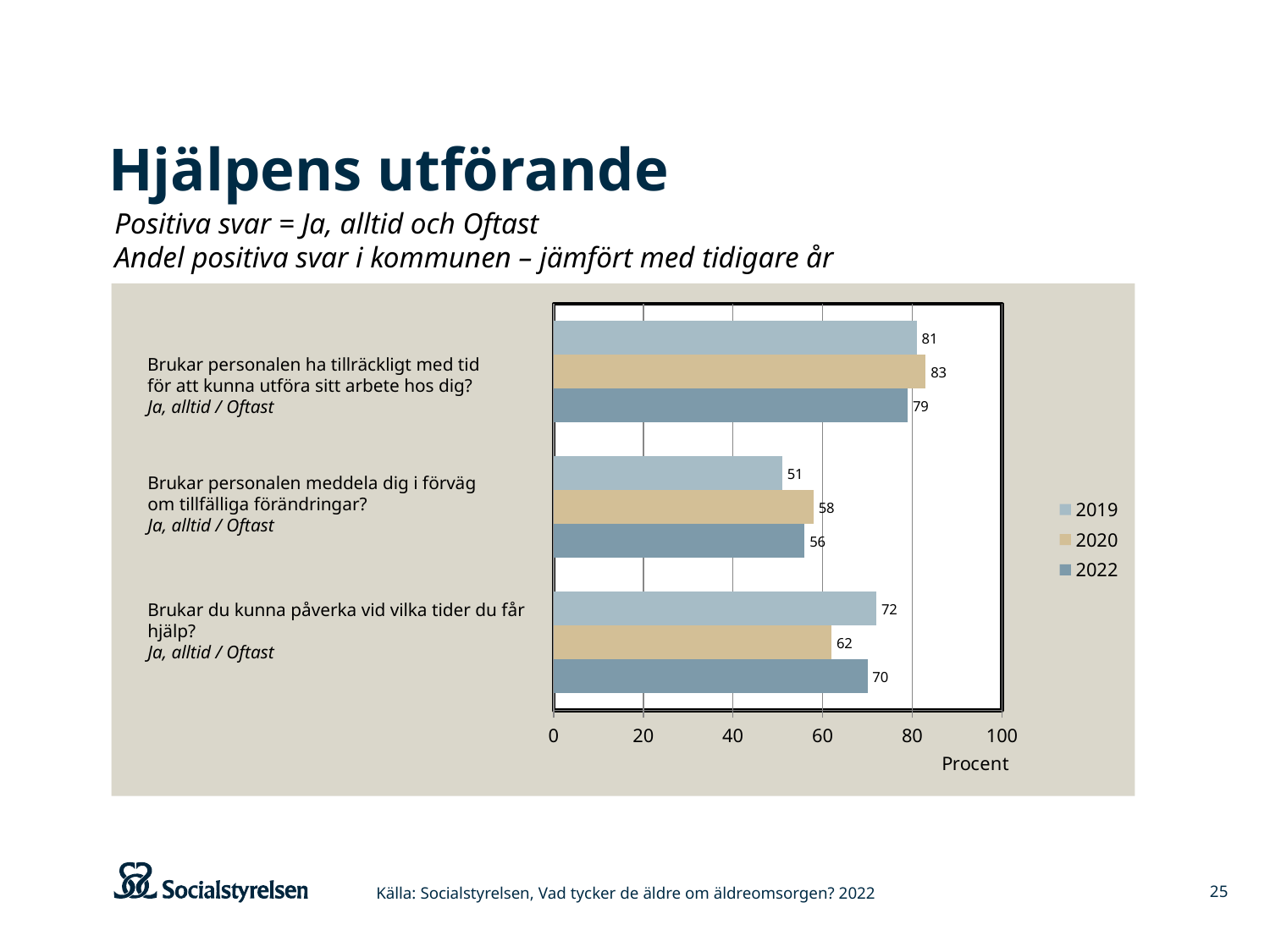
What kind of chart is shown on the slide? Bar chart For "Brukar personalen meddela dig i förväg om tillfälliga förändringar?", which year has the larger value, 2019 or 2020? 2020 What is the 2020 value for "Brukar personalen ha tillräckligt med tid för att kunna utföra sitt arbete hos dig?" 83 Which question has the lowest 2019 value? Brukar personalen meddela dig i förväg om tillfälliga förändringar? How many questions (categories) are shown in the chart? 3 What is the difference between the 2019 and 2020 values for "Brukar du kunna påverka vid vilka tider du får hjälp?" 10 What is the 2019 value for "Brukar du kunna påverka vid vilka tider du får hjälp?" 72 Is the 2022 value for "Brukar personalen ha tillräckligt med tid för att kunna utföra sitt arbete hos dig?" greater or less than 60? greater What is the 2022 value for "Brukar personalen meddela dig i förväg om tillfälliga förändringar?" 56 How many years does the legend list? 3 What is the label of the horizontal axis? Procent Which question has the highest 2022 value? Brukar personalen ha tillräckligt med tid för att kunna utföra sitt arbete hos dig?